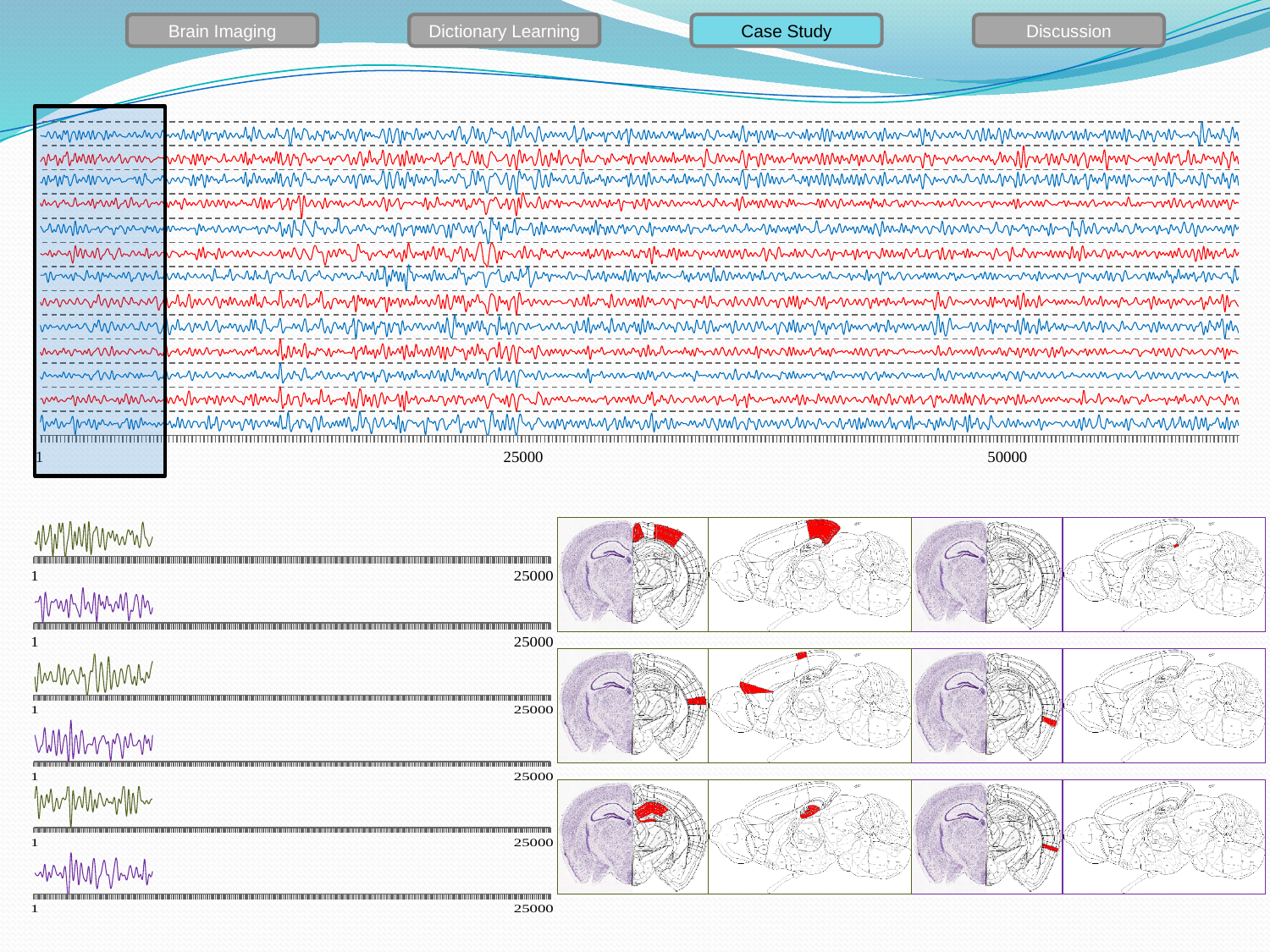
Which two colours are used for the traces in the top chart? blue and red How many brain atlas image panels are shown on the right side of the slide? 12 In the small plots at the bottom left, what is the last tick label on the x axis? 25000 How many signal traces are stacked in the top chart? 13 What kind of chart is the large plot at the top of the slide? line chart In the top chart, what is the middle tick label on the x axis? 25000 How many small time-series plots are shown in the bottom-left part of the slide? 6 In the top chart, what is the largest value labelled on the x axis? 50000 What colour is the trace in the topmost row of the top chart? blue In the top chart, what is the first tick label on the x axis? 1